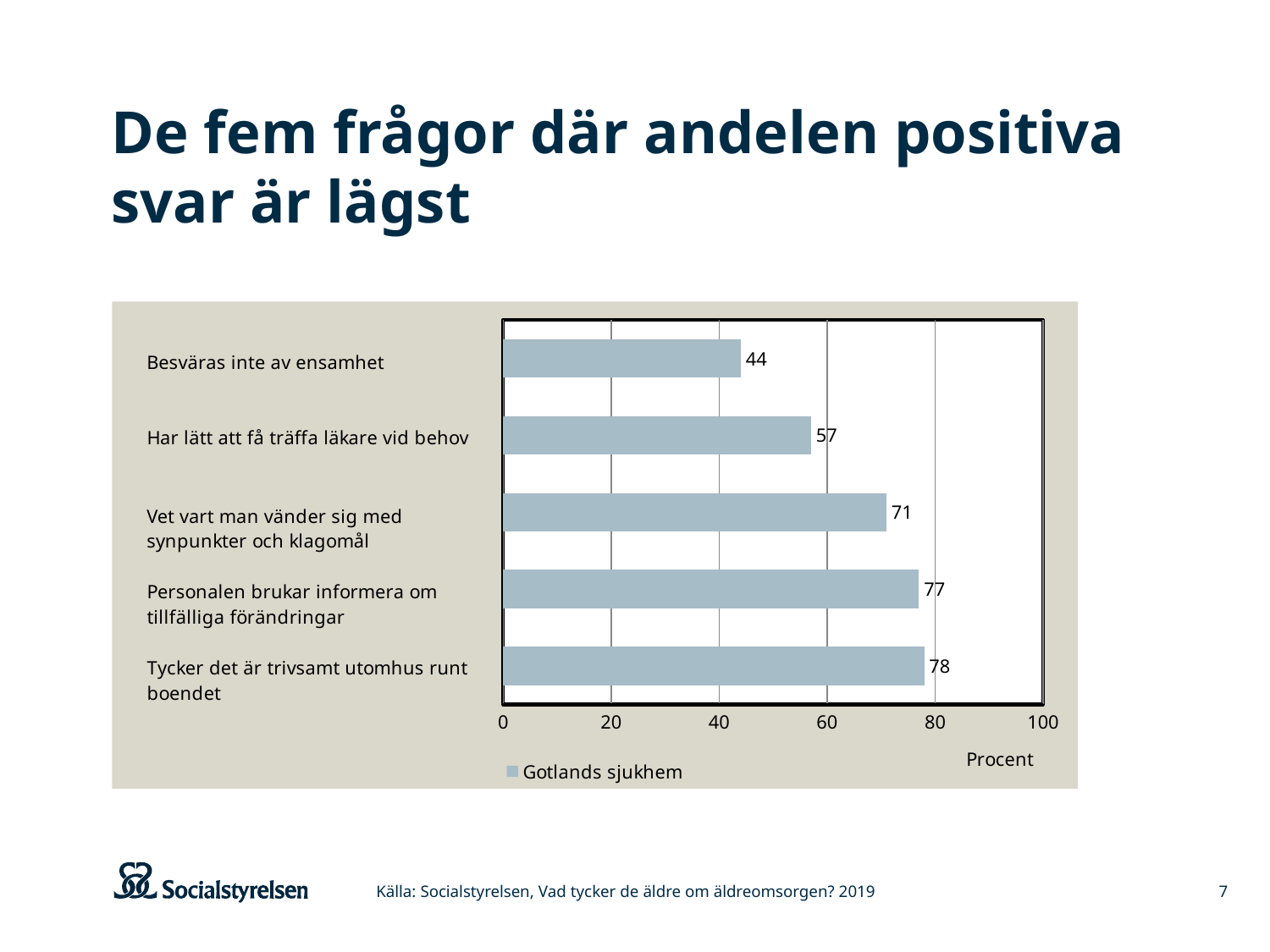
What is the value for "Personalen brukar informera om tillfälliga förändringar"? 77 What is the value for "Tycker det är trivsamt utomhus runt boendet"? 78 How many categories are shown in the chart? 5 What is the value for "Besväras inte av ensamhet"? 44 What kind of chart is shown on the slide? Bar chart What is the value for "Har lätt att få träffa läkare vid behov"? 57 Which category has the lowest value? Besväras inte av ensamhet What series does the legend list? Gotlands sjukhem What is the value for "Vet vart man vänder sig med synpunkter och klagomål"? 71 Which is larger, the value for "Har lätt att få träffa läkare vid behov" or the value for "Vet vart man vänder sig med synpunkter och klagomål"? Vet vart man vänder sig med synpunkter och klagomål What is the difference between the values for "Vet vart man vänder sig med synpunkter och klagomål" and "Besväras inte av ensamhet"? 27 Which category has the highest value? Tycker det är trivsamt utomhus runt boendet